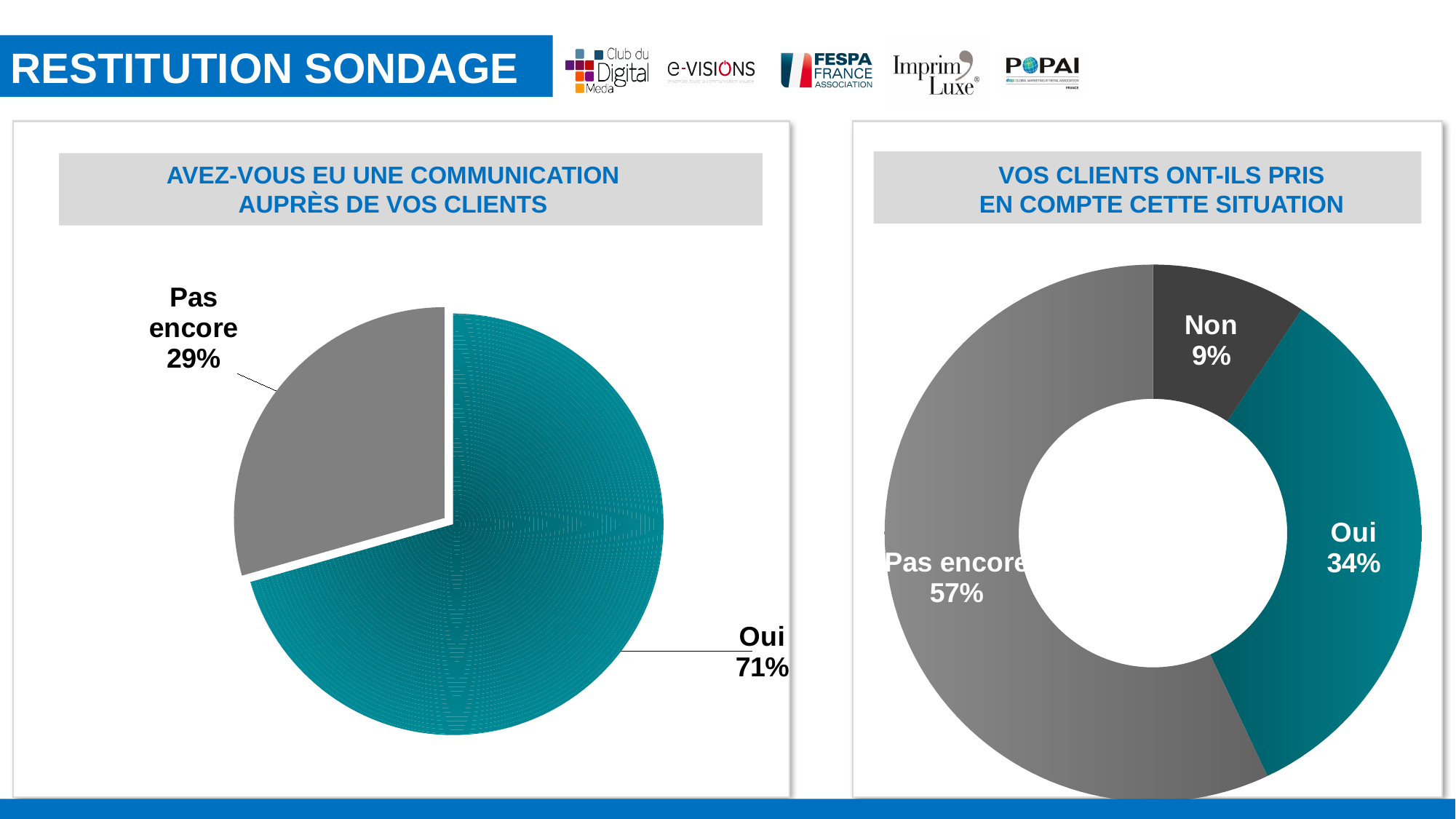
How many categories does the left chart 'AVEZ-VOUS EU UNE COMMUNICATION AUPRÈS DE VOS CLIENTS' show? 2 In the left chart 'AVEZ-VOUS EU UNE COMMUNICATION AUPRÈS DE VOS CLIENTS', which category has the largest share? Oui In the right chart 'VOS CLIENTS ONT-ILS PRIS EN COMPTE CETTE SITUATION', which is larger, 'Oui' or 'Pas encore'? Pas encore In the left chart 'AVEZ-VOUS EU UNE COMMUNICATION AUPRÈS DE VOS CLIENTS', what is the value for 'Oui'? 71% In the right chart 'VOS CLIENTS ONT-ILS PRIS EN COMPTE CETTE SITUATION', which category has the smallest share? Non In the left chart 'AVEZ-VOUS EU UNE COMMUNICATION AUPRÈS DE VOS CLIENTS', what is the value for 'Pas encore'? 29% In the right chart 'VOS CLIENTS ONT-ILS PRIS EN COMPTE CETTE SITUATION', what is the value for 'Pas encore'? 57% In the right chart 'VOS CLIENTS ONT-ILS PRIS EN COMPTE CETTE SITUATION', what is the value for 'Oui'? 34% What kind of chart is the left chart 'AVEZ-VOUS EU UNE COMMUNICATION AUPRÈS DE VOS CLIENTS'? Pie chart In the right chart 'VOS CLIENTS ONT-ILS PRIS EN COMPTE CETTE SITUATION', what is the value for 'Non'? 9% How many categories does the right chart 'VOS CLIENTS ONT-ILS PRIS EN COMPTE CETTE SITUATION' show? 3 In the left chart 'AVEZ-VOUS EU UNE COMMUNICATION AUPRÈS DE VOS CLIENTS', what is the difference between 'Oui' and 'Pas encore'? 42%